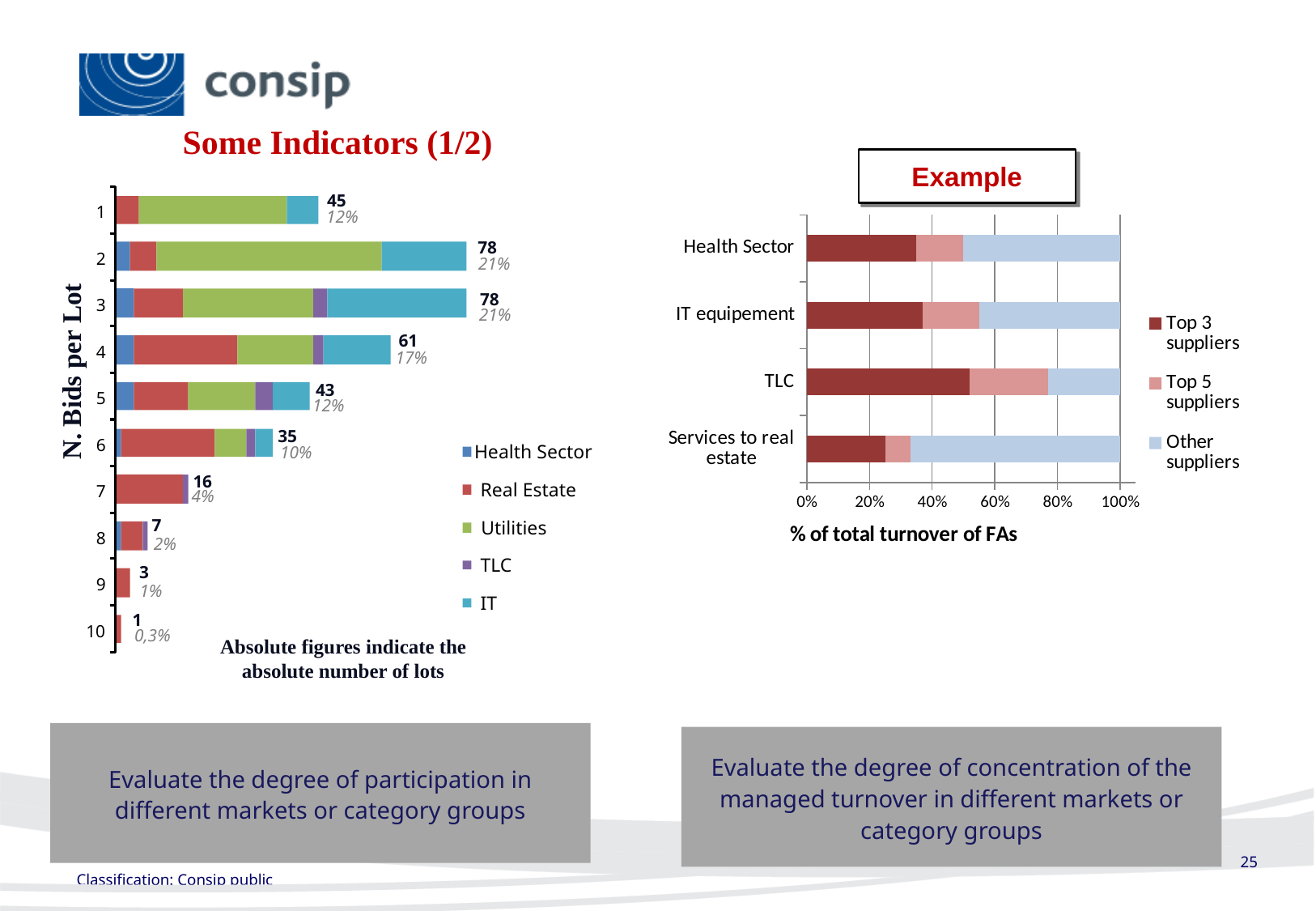
On the left chart (N. Bids per Lot), which has a larger total number of lots: 4 bids per lot or 5 bids per lot? 4 What kind of chart is the right chart (% of total turnover of FAs)? bar chart On the left chart (N. Bids per Lot), what percentage is shown for 4 bids per lot? 17% On the right chart (% of total turnover of FAs), is the Top 3 suppliers share for Services to real estate greater or less than 40%? less On the left chart (N. Bids per Lot), what is the difference between the total for 3 bids per lot and the total for 1 bid per lot? 33 On the left chart (N. Bids per Lot), do the total numbers of lots rise or fall going from 3 bids per lot to 10 bids per lot? fall On the right chart (% of total turnover of FAs), what are the three legend entries? Top 3 suppliers, Top 5 suppliers, Other suppliers On the right chart (% of total turnover of FAs), which category has the largest share for Top 3 suppliers? TLC On the left chart (N. Bids per Lot), what is the total number of lots for 2 bids per lot? 78 On the left chart (N. Bids per Lot), how many series does the legend list? 5 On the left chart (N. Bids per Lot), how many bids-per-lot categories are shown? 10 On the left chart (N. Bids per Lot), which number of bids per lot has the lowest total number of lots? 10